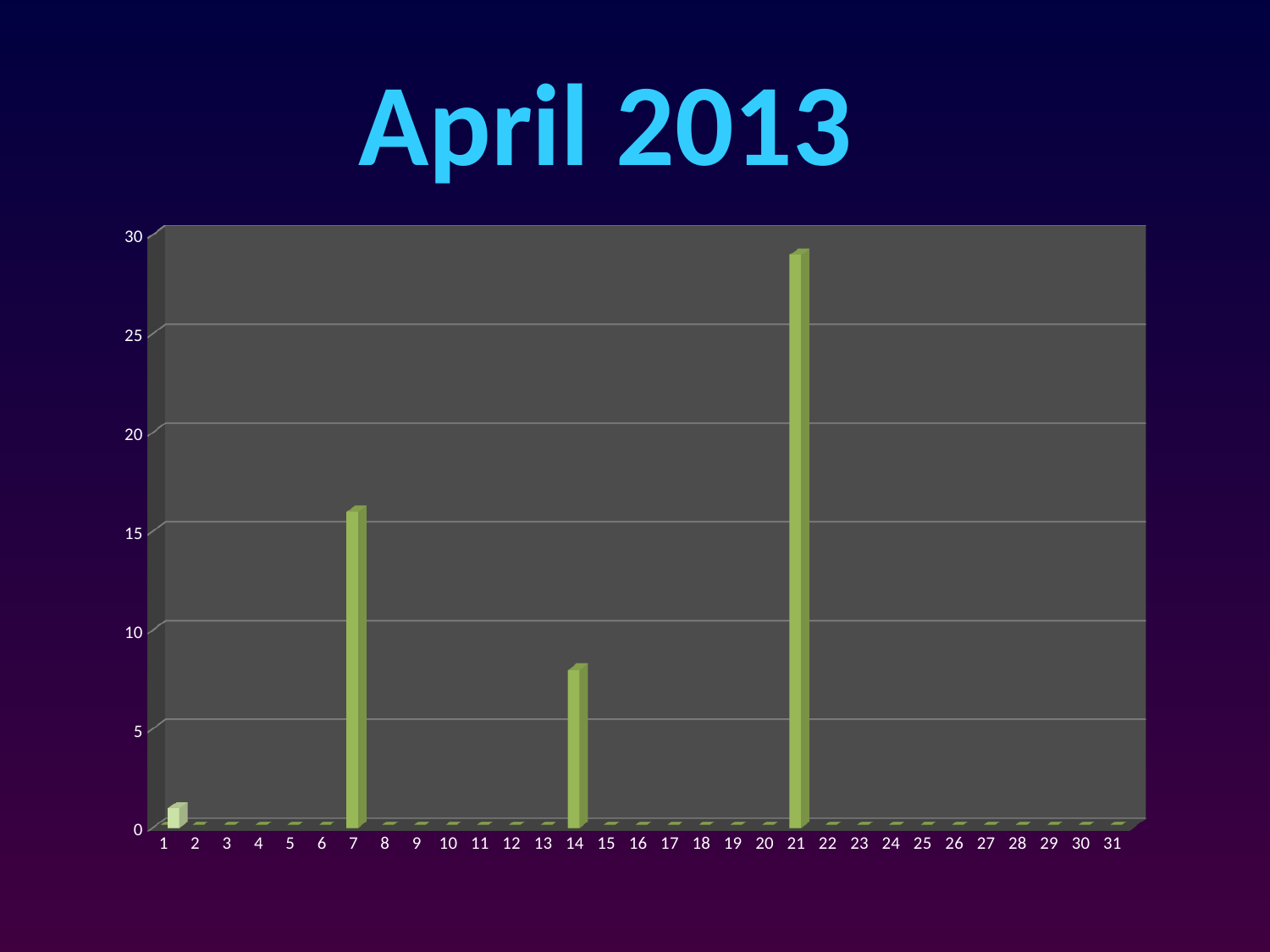
How many categories are shown along the x axis? 31 Which has the larger value, day 7 or day 14? day 7 Which day has the tallest bar? 21 What kind of chart is shown on the slide? bar chart Is the value for day 21 greater or less than 25? greater Is the value for day 1 greater or less than 5? less How many days have a visible non-zero bar? 4 What is the title of the chart? April 2013 Is the value for day 14 greater or less than 10? less